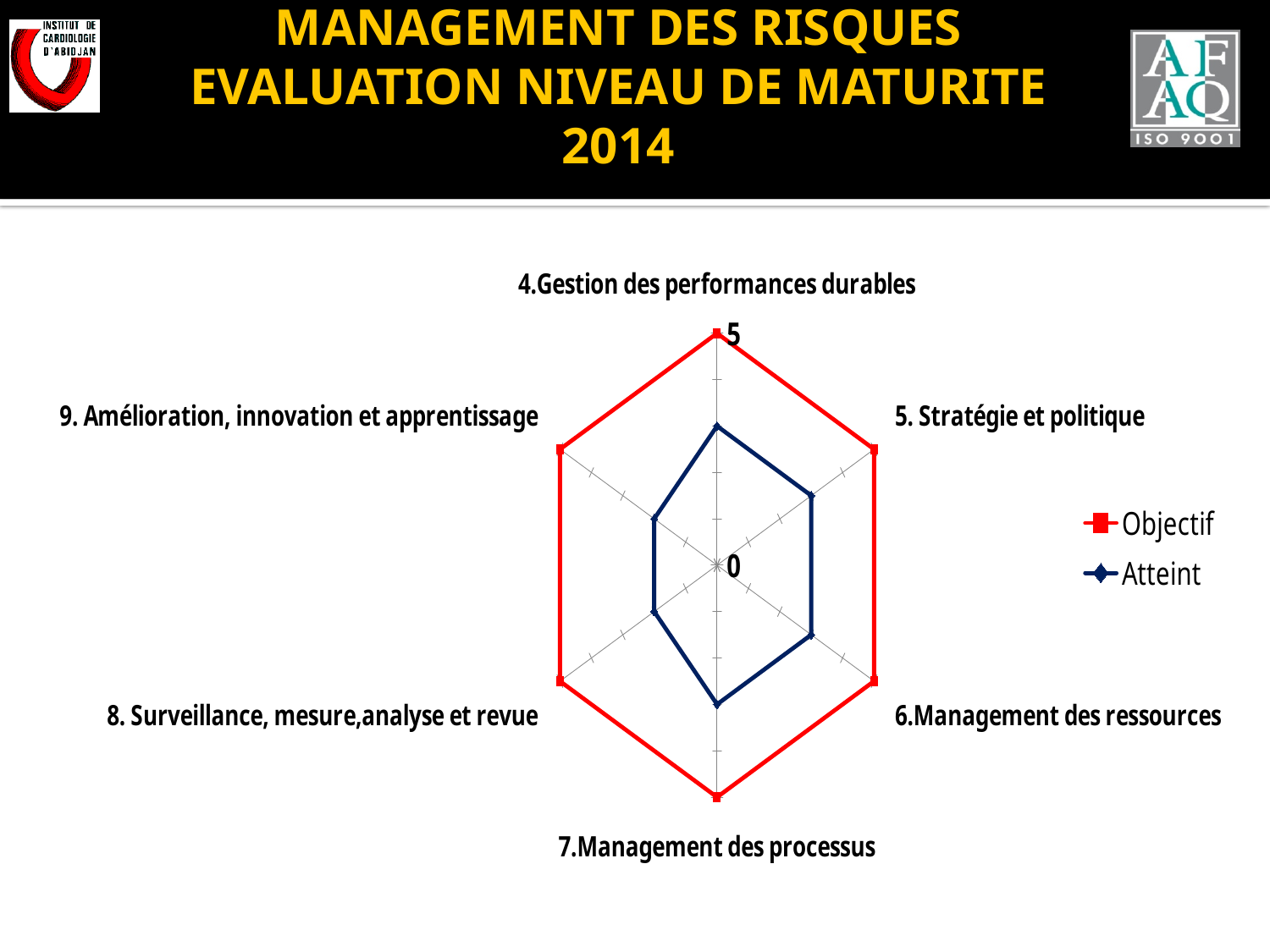
Which series is drawn in red? Objectif What is the Objectif value for 7.Management des processus? 5 What is the Objectif value for 4.Gestion des performances durables? 5 Is the Atteint value for 9. Amélioration, innovation et apprentissage greater or less than 5? less How many series does the legend list? 2 For 8. Surveillance, mesure,analyse et revue, which series has the larger value, Objectif or Atteint? Objectif What is the maximum value shown on the radar chart's axis? 5 What are the two series named in the legend? Objectif and Atteint What is the Objectif value for 6.Management des ressources? 5 How many categories (axes) does the radar chart have? 6 What kind of chart is shown on the slide? Radar chart Is the Atteint value for 5. Stratégie et politique greater or less than 5? less